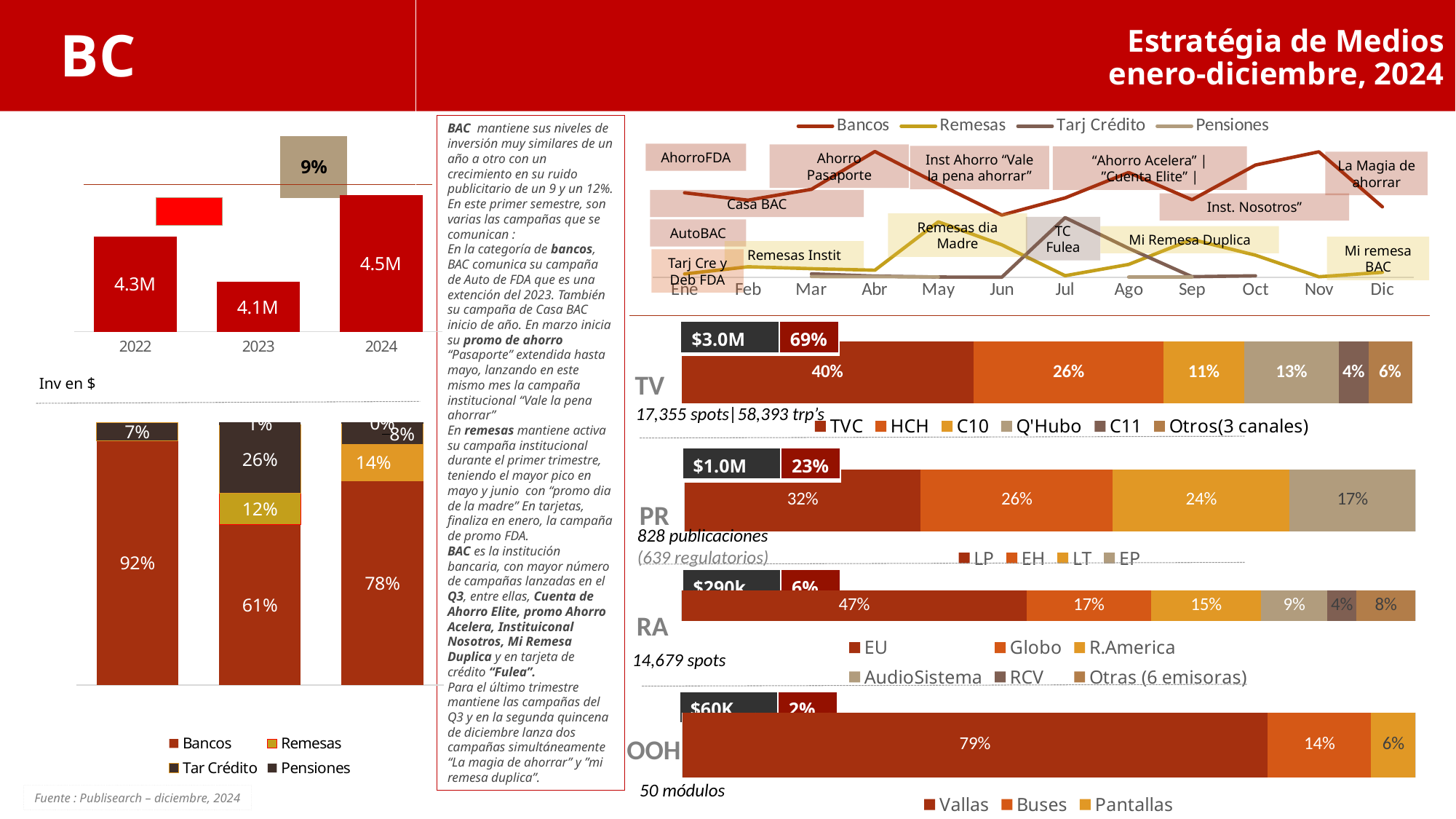
In the 'Inv en $' bar chart at the top left, what is the difference between the 2024 and 2023 values? 0.4M In the 'Inv en $' bar chart at the top left, which year has the lowest investment? 2023 In the TV stacked bar, which channel has the largest share? TVC In the stacked percentage bar chart at the bottom left, what is the share for Remesas in 2024? 14% In the stacked percentage bar chart at the bottom left, how many series does the legend list? 4 In the PR stacked bar, what is the difference between the LP and EP shares? 15% In the RA stacked bar, which is larger, Globo or R.America? Globo In the TV stacked bar, what is the share for HCH? 26% In the line chart at the top right, how many series does the legend list? 4 In the 'Inv en $' bar chart at the top left, what is the value for 2024? 4.5M In the stacked percentage bar chart at the bottom left, what is the share for Bancos in 2023? 61% In the 'Inv en $' bar chart at the top left, how many years are shown? 3